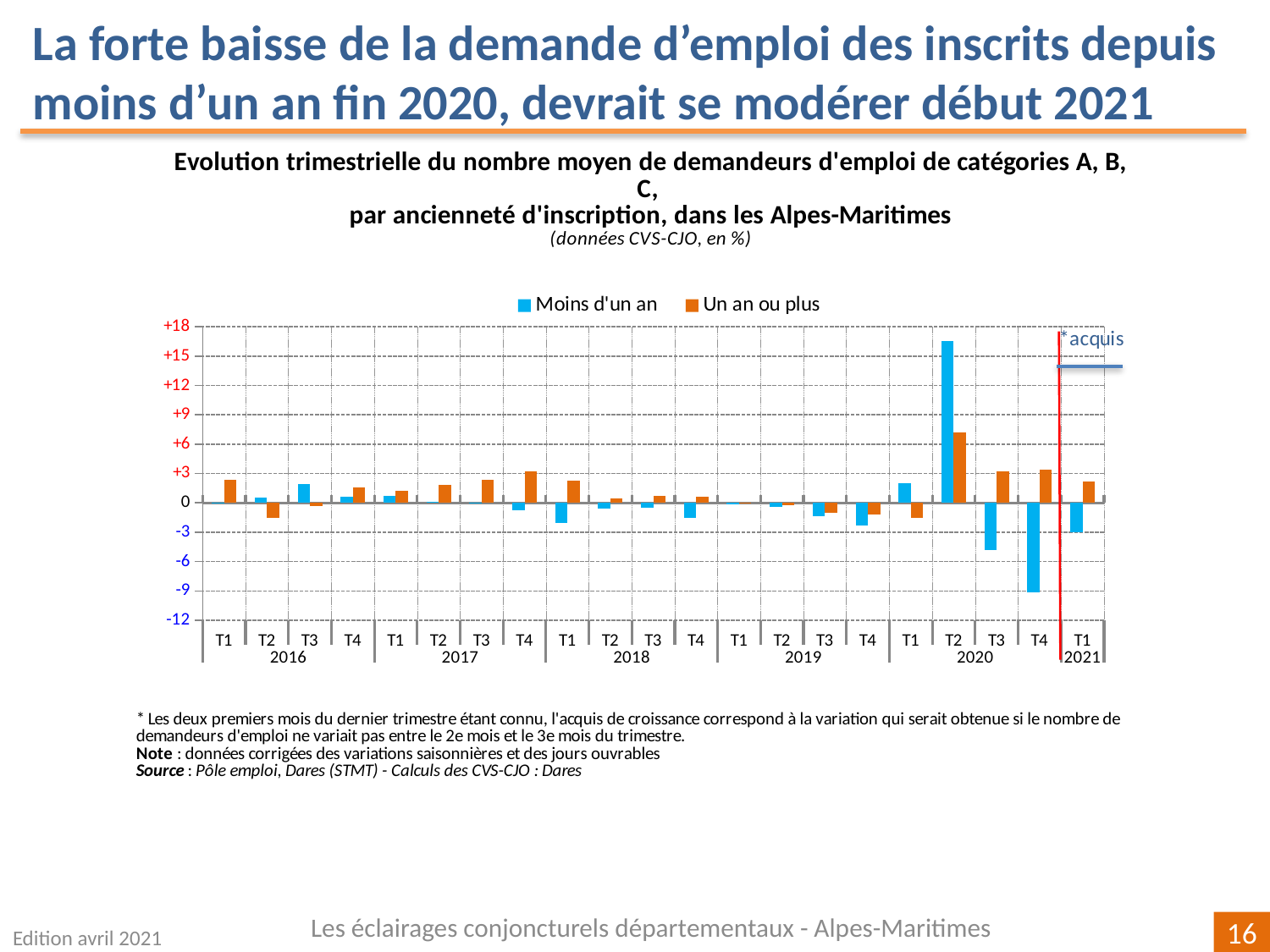
Is the value for 'Un an ou plus' in T2 2020 greater or less than +3? greater In which quarter does the 'Un an ou plus' series reach its highest value? T2 2020 Is the value for 'Moins d'un an' in T4 2020 greater or less than -6? less In T4 2020, which series has the larger value, 'Moins d'un an' or 'Un an ou plus'? Un an ou plus Which colour represents the 'Un an ou plus' series in the legend? orange In which quarter does the 'Moins d'un an' series reach its lowest value? T4 2020 In which quarter does the 'Moins d'un an' series reach its highest value? T2 2020 Is the value for 'Moins d'un an' in T2 2020 greater or less than +15? greater How many series does the legend list? 2 In T2 2020, which series has the larger value, 'Moins d'un an' or 'Un an ou plus'? Moins d'un an What kind of chart is shown on the slide? bar chart How many quarters are plotted along the x axis? 21